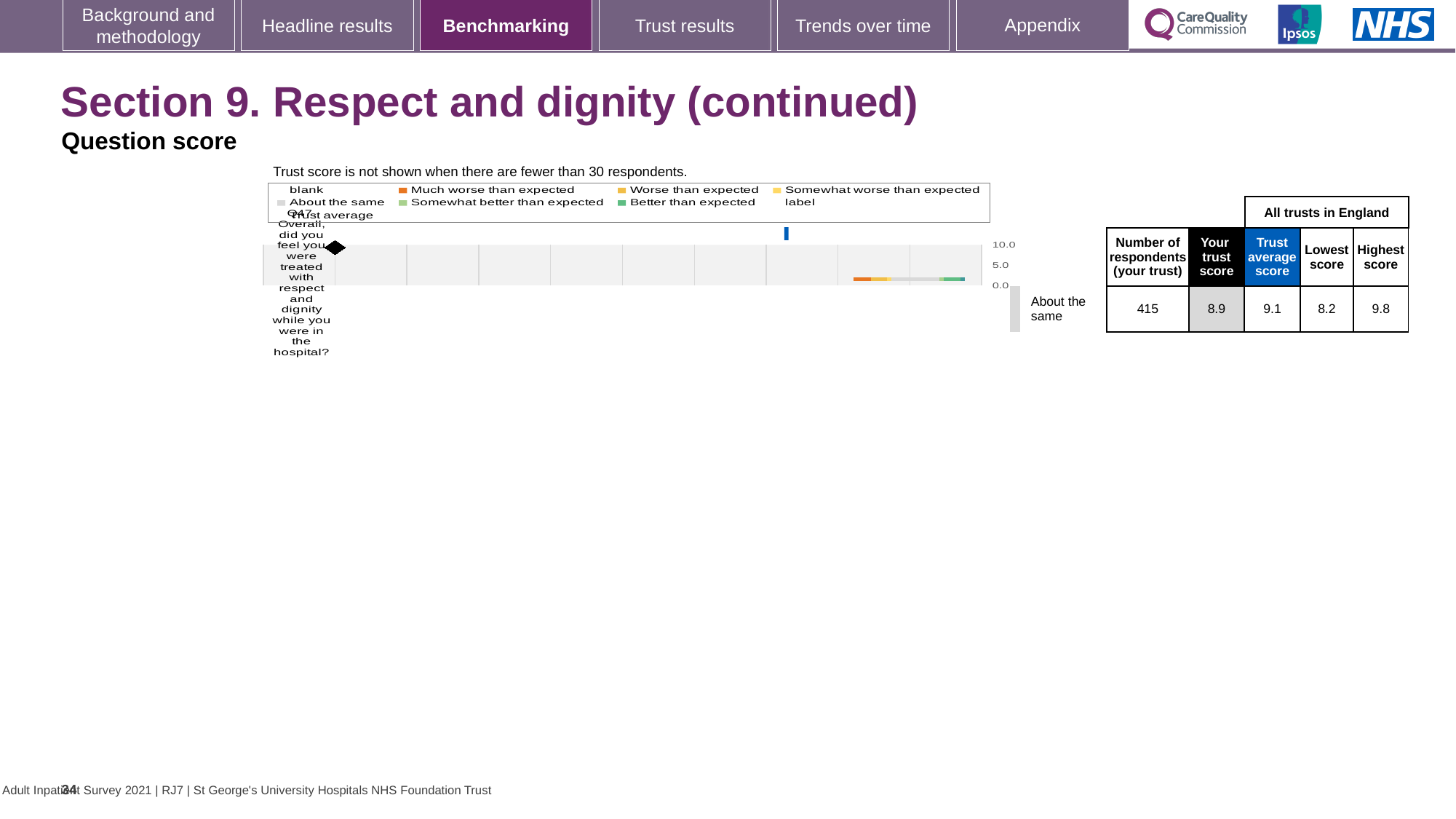
What is the difference between the highest and lowest scores for Q47 across all trusts in England? 1.6 What is the trust's score for Q47? 8.9 Which question number is shown on the chart? Q47 Which benchmark category is the trust's Q47 score placed in? About the same What is the highest score among all trusts in England for Q47? 9.8 What type of chart is used to show the Q47 question score? bar chart Which is larger for Q47: the trust's score or the trust average score? Trust average score What is the lowest score among all trusts in England for Q47? 8.2 What is the highest value shown on the chart's score axis? 10.0 How many survey questions are plotted on the chart? 1 What is the trust average score for Q47 across all trusts in England? 9.1 How many respondents from the trust answered Q47? 415